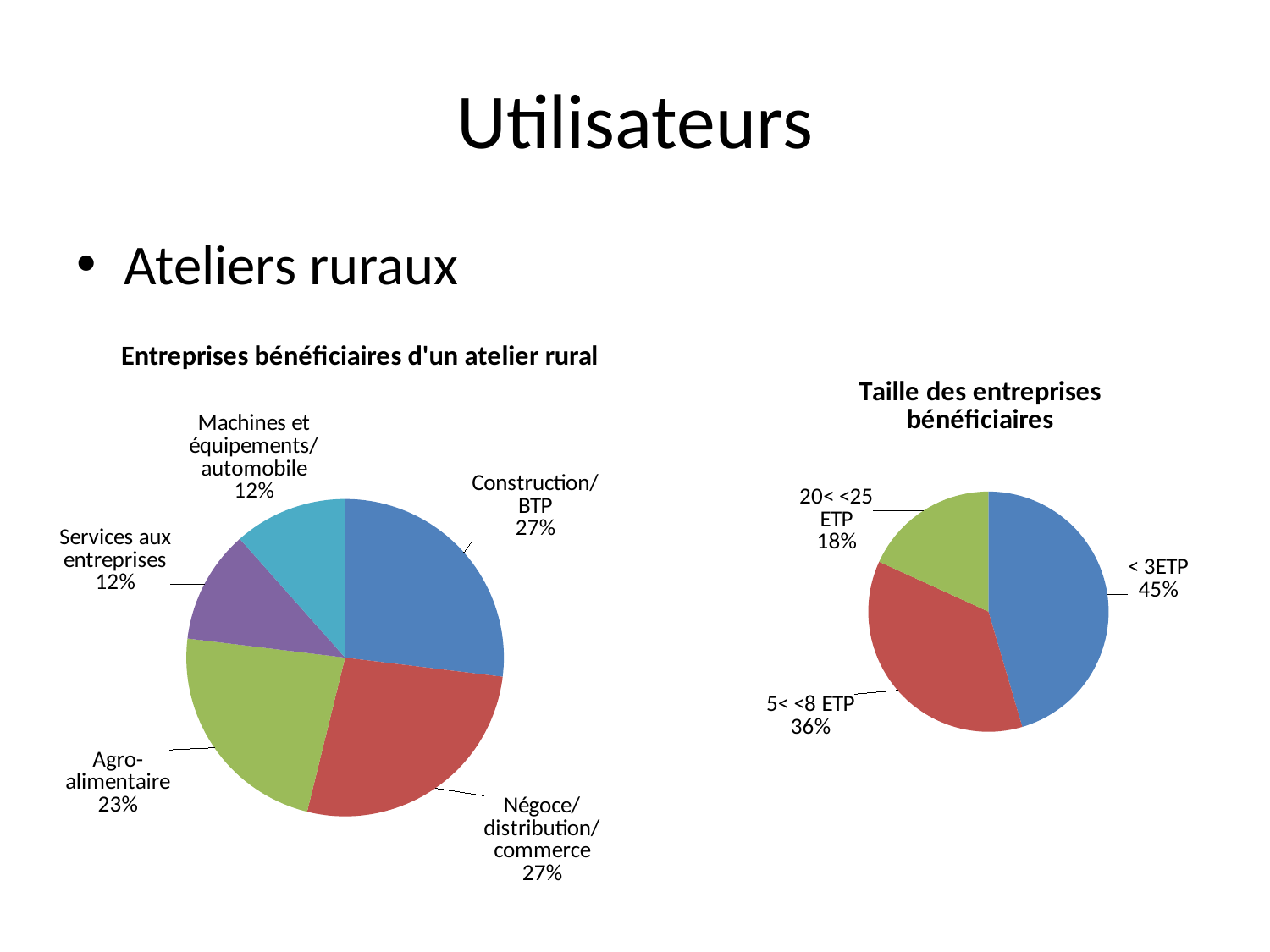
In the chart 'Entreprises bénéficiaires d'un atelier rural', how many slices does the pie have? 5 In the chart 'Taille des entreprises bénéficiaires', what is the difference between the shares of 5< <8 ETP and 20< <25 ETP? 18% In the chart 'Entreprises bénéficiaires d'un atelier rural', which is larger: Agro-alimentaire or Machines et équipements/automobile? Agro-alimentaire In the chart 'Taille des entreprises bénéficiaires', which category has the largest share? < 3ETP In the chart 'Entreprises bénéficiaires d'un atelier rural', what share does Agro-alimentaire have? 23% In the chart 'Entreprises bénéficiaires d'un atelier rural', what share does Services aux entreprises have? 12% What kind of chart is 'Taille des entreprises bénéficiaires'? Pie chart In the chart 'Taille des entreprises bénéficiaires', how many categories are shown? 3 In the chart 'Entreprises bénéficiaires d'un atelier rural', what share does Construction/BTP have? 27% In the chart 'Entreprises bénéficiaires d'un atelier rural', what is the difference between the shares of Négoce/distribution/commerce and Services aux entreprises? 15% In the chart 'Taille des entreprises bénéficiaires', which category has the smallest share? 20< <25 ETP In the chart 'Taille des entreprises bénéficiaires', what share do enterprises with < 3ETP have? 45%